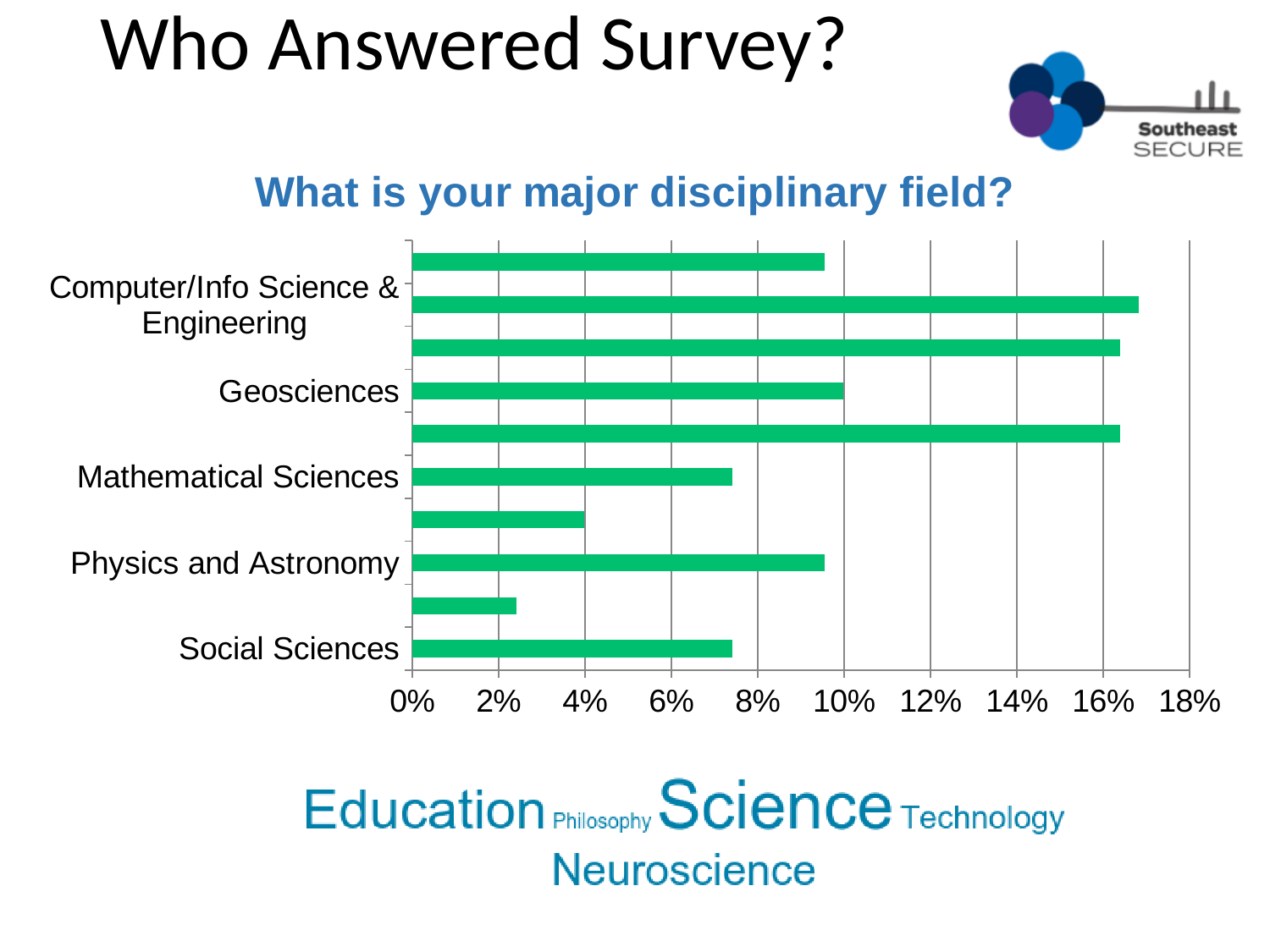
Is the value for Geosciences greater or less than 8%? greater Which has the larger value, Computer/Info Science & Engineering or Geosciences? Computer/Info Science & Engineering Which has the larger value, Physics and Astronomy or Social Sciences? Physics and Astronomy What kind of chart is shown on the slide? bar chart Is the value for Computer/Info Science & Engineering greater or less than 16%? greater What is the title of the chart? What is your major disciplinary field? Is the value for Physics and Astronomy greater or less than 8%? greater What is the highest value shown on the chart's percentage axis? 18% How many bars are plotted in the chart? 10